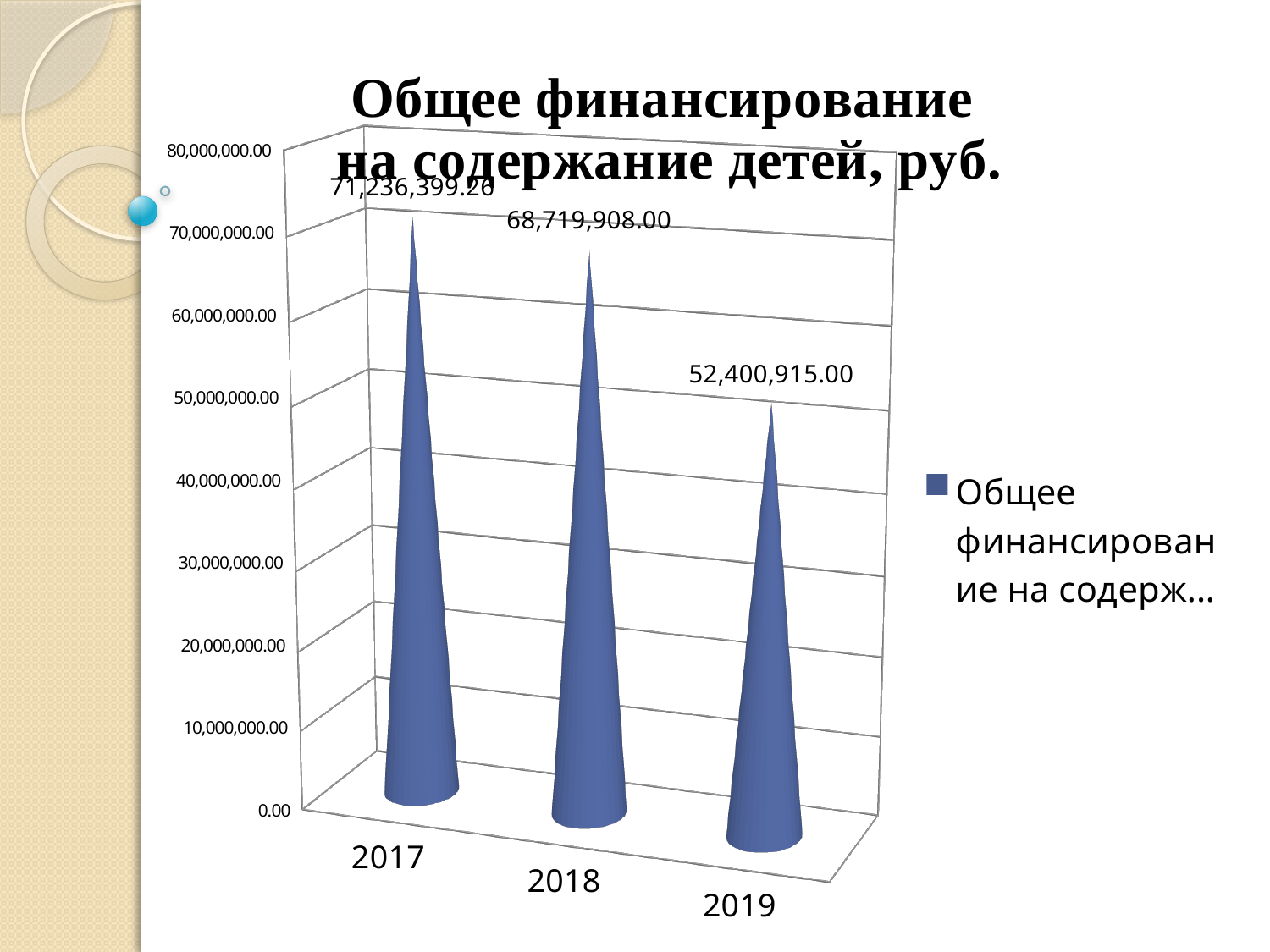
Which is larger, the value for 2018 or the value for 2019? 2018 Which year has the lowest value? 2019 What is the value for 2017? 71,236,399.26 How many years are shown on the x axis? 3 Which year has the highest value? 2017 Is the value for 2019 greater or less than 60,000,000.00? less What is the title of the chart? Общее финансирование на содержание детей, руб. What is the difference between the values for 2017 and 2018? 2,516,491.26 What is the difference between the values for 2018 and 2019? 16,318,993.00 Do the values rise or fall from 2017 to 2019? fall What is the value for 2018? 68,719,908.00 What is the value for 2019? 52,400,915.00